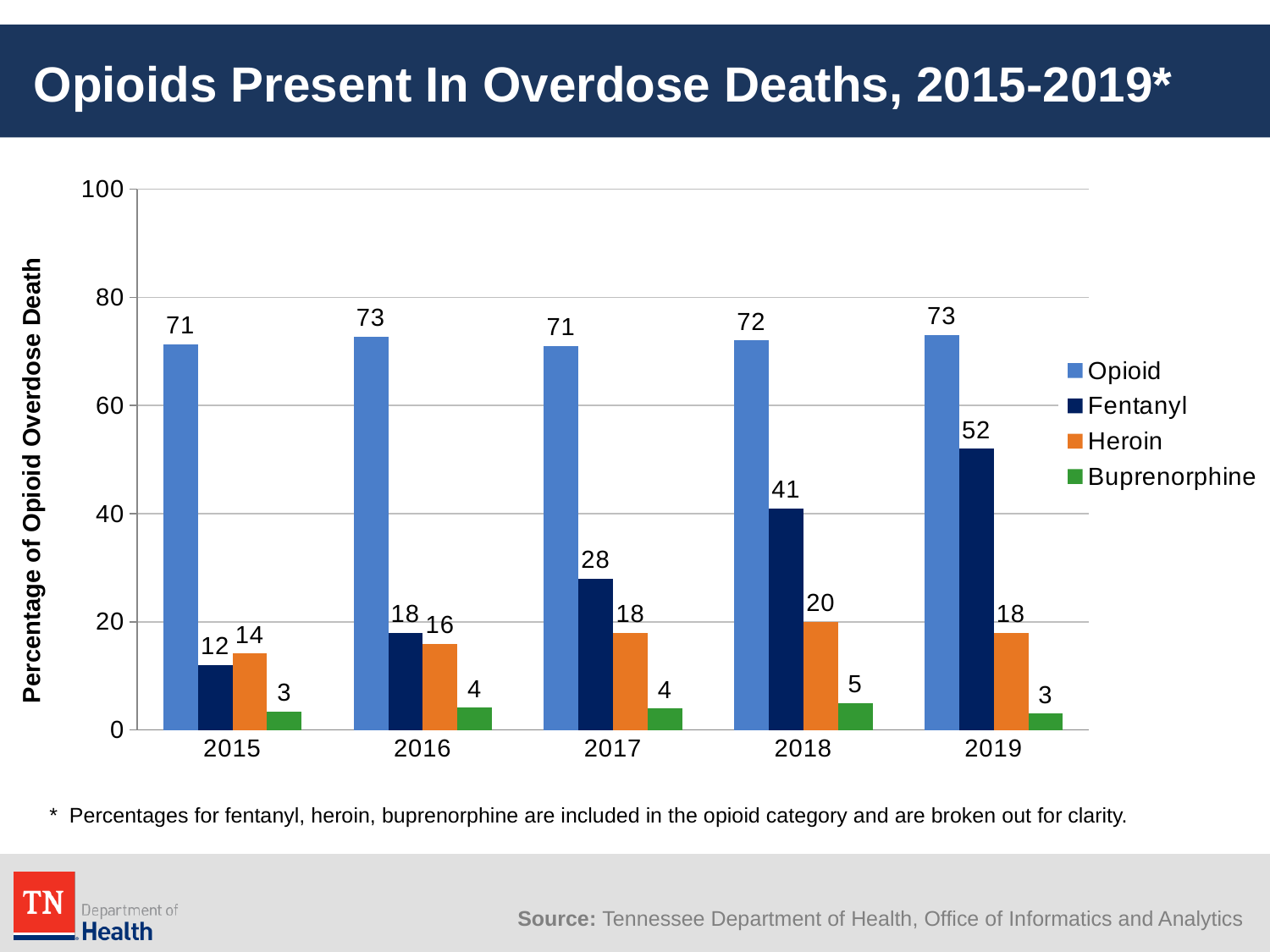
How many years are shown on the x axis? 5 What is the Heroin value for 2018? 20 Is the Fentanyl value for 2018 greater or less than 40? greater What is the difference between the Fentanyl values for 2019 and 2018? 11 In which year is the Fentanyl value highest? 2019 Which is larger in 2015, the Fentanyl value or the Heroin value? Heroin Does the Fentanyl value rise or fall from 2015 to 2019? rise What is the Fentanyl value for 2019? 52 What is the Opioid value for 2015? 71 How many series does the legend list? 4 What kind of chart is shown on the slide? bar chart In which year is the Fentanyl value lowest? 2015